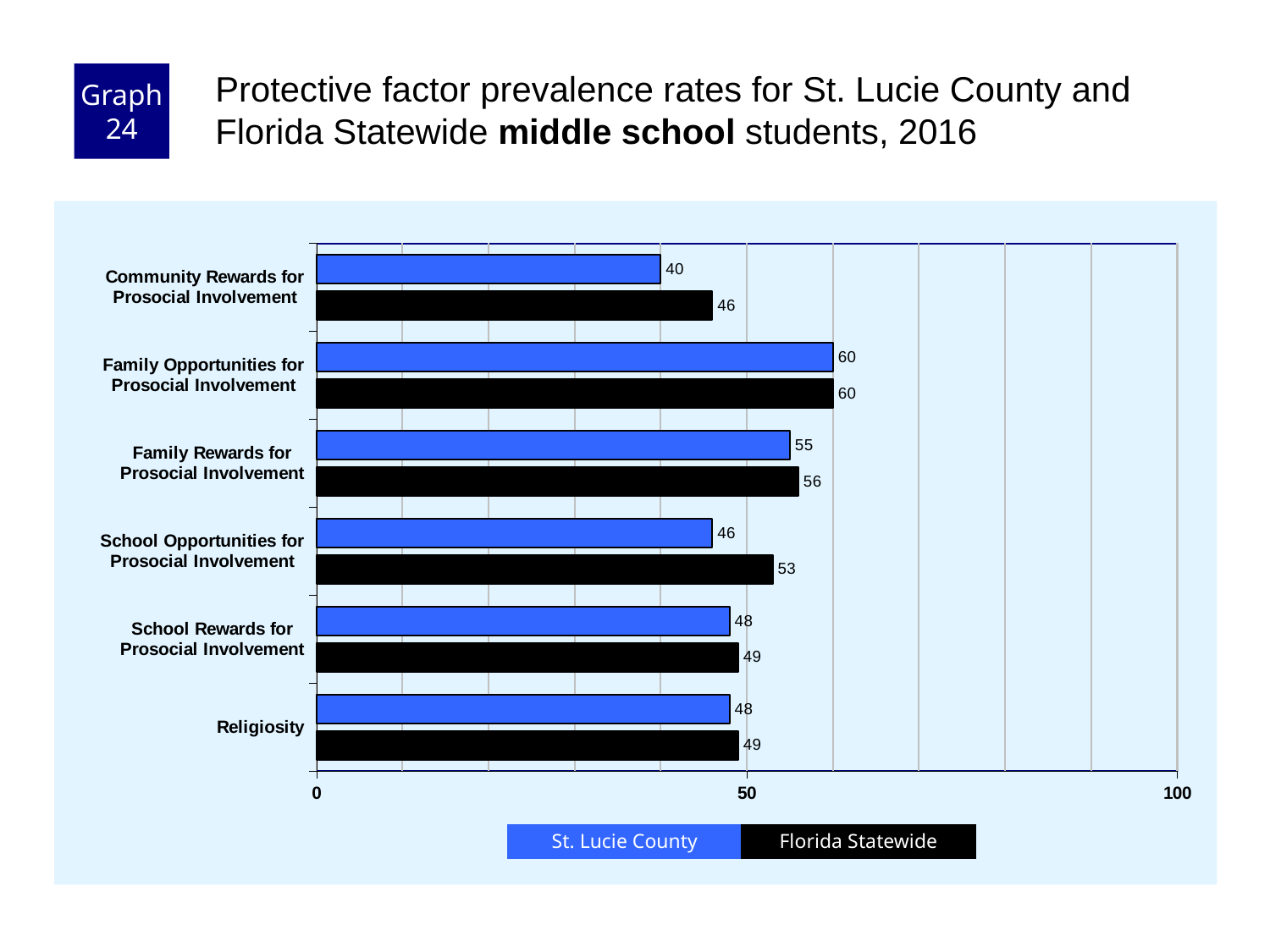
What is the difference between the Florida Statewide and St. Lucie County values for School Opportunities for Prosocial Involvement? 7 Is the St. Lucie County value for Family Rewards for Prosocial Involvement greater or less than 50? greater How many series does the legend list? 2 What kind of chart is shown on the slide? bar chart Which colour represents Florida Statewide in the chart? black Which protective factor has the highest St. Lucie County value? Family Opportunities for Prosocial Involvement What is the Florida Statewide value for School Opportunities for Prosocial Involvement? 53 For Community Rewards for Prosocial Involvement, which is larger: the St. Lucie County value or the Florida Statewide value? Florida Statewide Which protective factor has the lowest St. Lucie County value? Community Rewards for Prosocial Involvement What is the Florida Statewide value for Religiosity? 49 What is the St. Lucie County value for Community Rewards for Prosocial Involvement? 40 How many protective factors are shown on the chart? 6